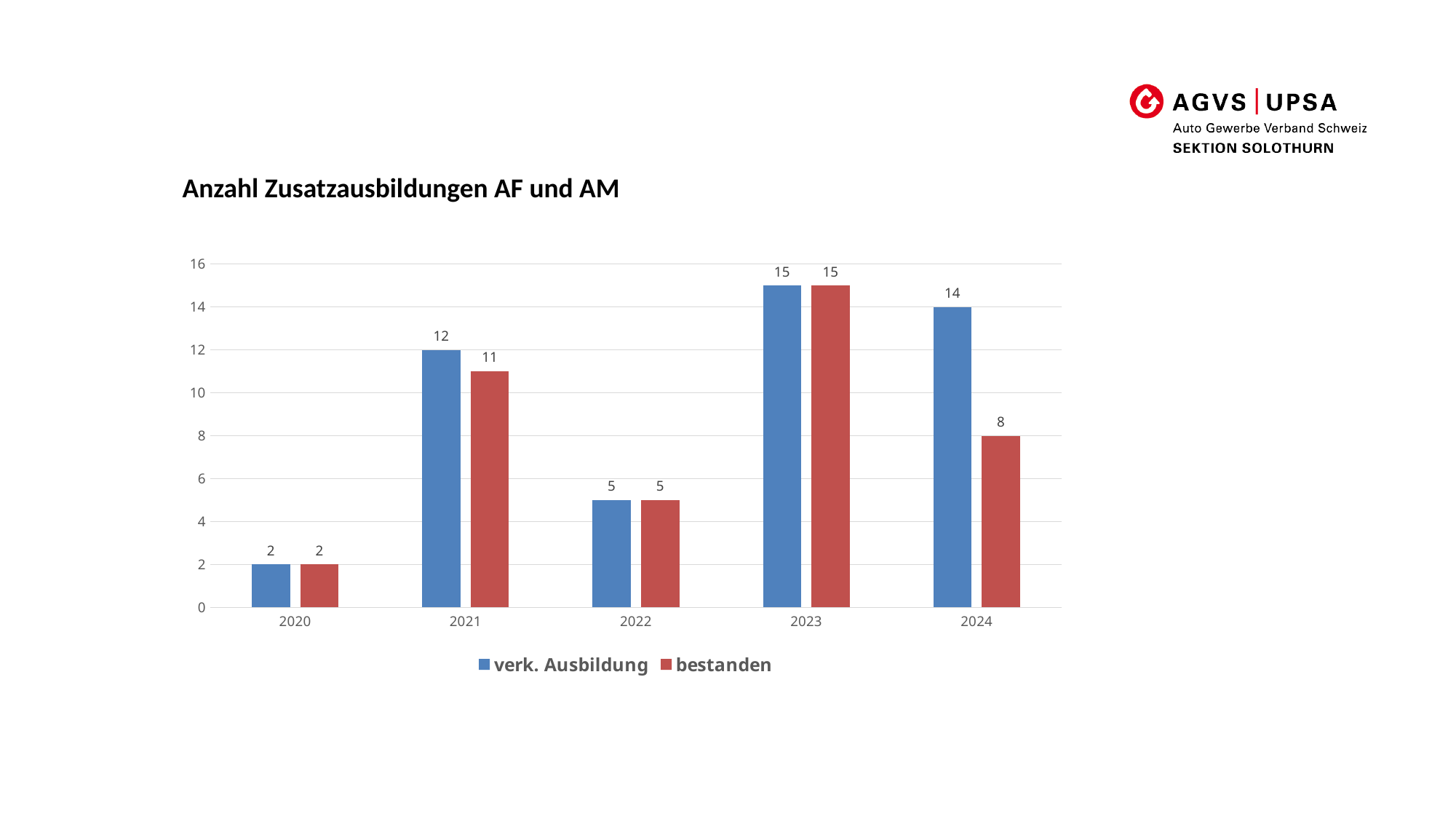
What is the value for bestanden in 2024? 8 How many years are shown on the x axis? 5 What is the value for verk. Ausbildung in 2021? 12 Which colour represents the bestanden series? red What is the difference between verk. Ausbildung and bestanden in 2024? 6 How many series does the legend list? 2 What kind of chart is shown on the slide? bar chart What is the title of the chart? Anzahl Zusatzausbildungen AF und AM Which year has the highest value for verk. Ausbildung? 2023 What is the value for bestanden in 2021? 11 Which year has the lowest value for bestanden? 2020 Which is larger in 2021: verk. Ausbildung or bestanden? verk. Ausbildung